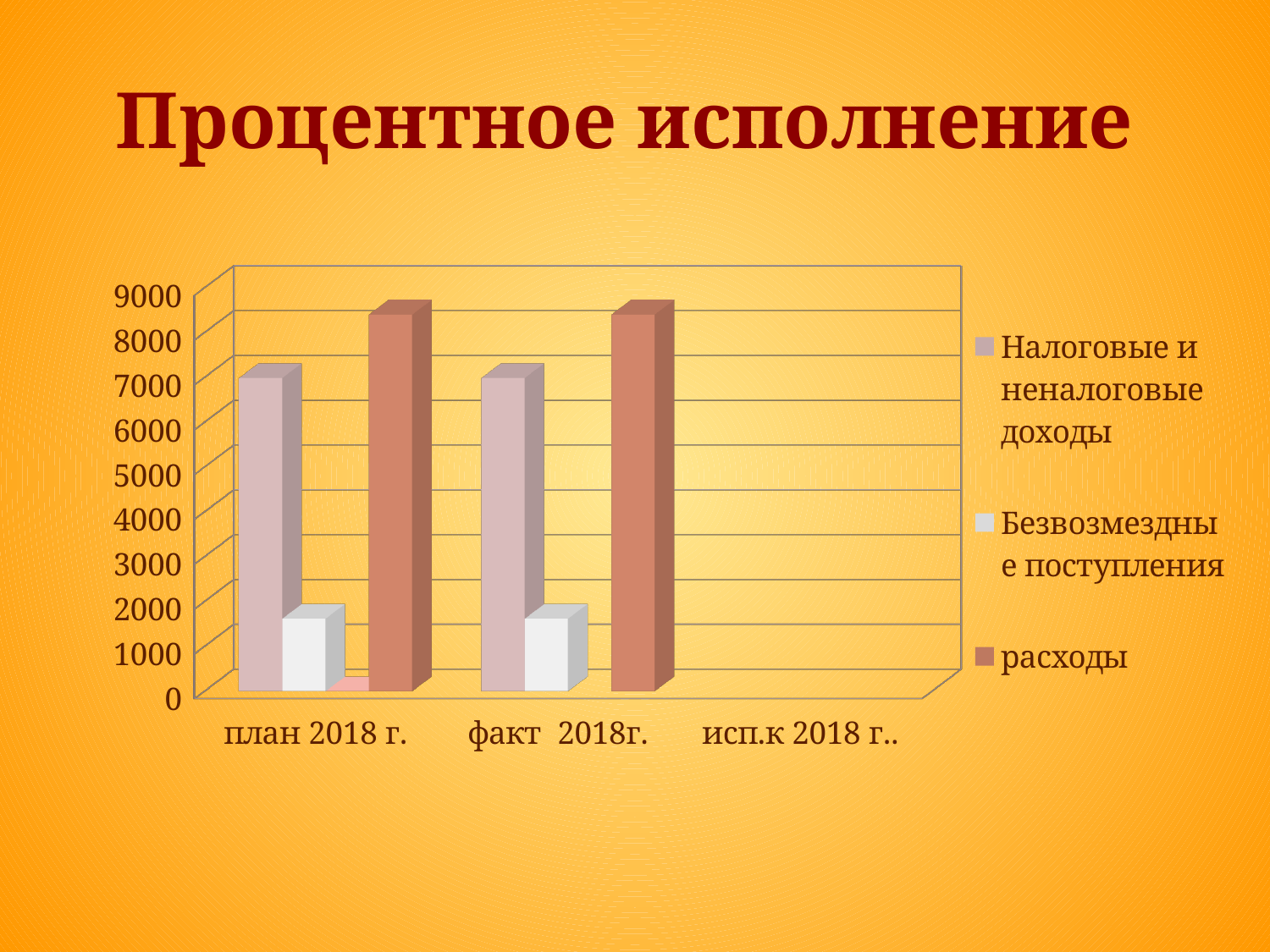
What is the title of the slide containing the chart? Процентное исполнение Is the value for Налоговые и неналоговые доходы in план 2018 г. greater or less than 5000? greater Which series is shown in the darkest brown colour in the legend? расходы How many categories are shown on the x axis? 3 How many series does the legend list? 3 Which series has the lowest value in план 2018 г.? Безвозмездные поступления Is the value for Безвозмездные поступления in план 2018 г. greater or less than 3000? less Is the value for Безвозмездные поступления in факт 2018г. greater or less than 1000? greater What kind of chart is shown on the slide? bar chart Which series has the highest value in факт 2018г.? расходы Which is larger in план 2018 г.: расходы or Налоговые и неналоговые доходы? расходы